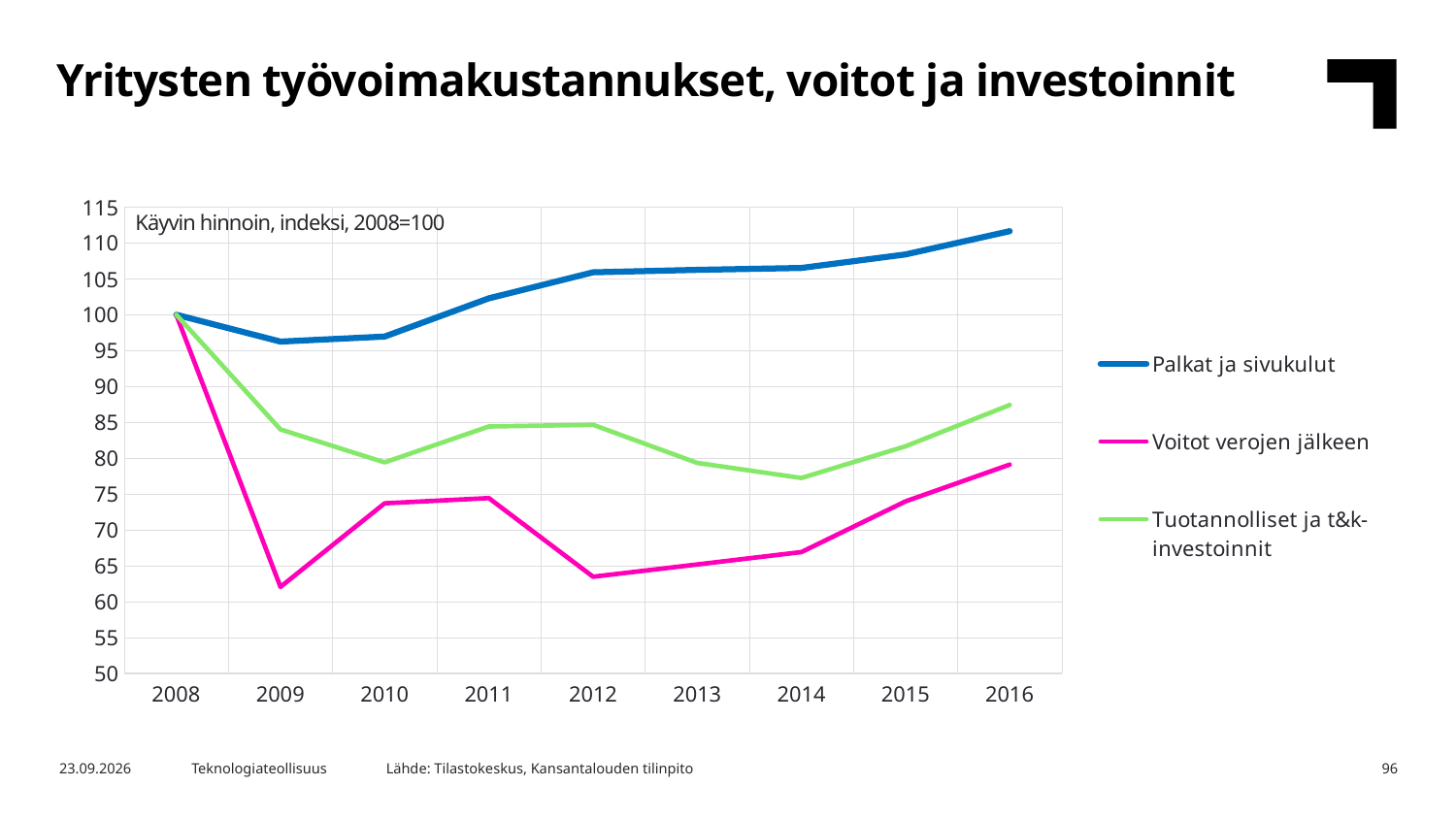
What is the index value of all three series in 2008? 100 How many years are shown on the x axis? 9 Is the value for Palkat ja sivukulut in 2016 greater or less than 110? greater Does the Palkat ja sivukulut line rise or fall from 2012 to 2016? Rise Which series has the highest value in 2016? Palkat ja sivukulut Is the value for Voitot verojen jälkeen in 2009 greater or less than 65? less What type of chart is shown on the slide? Line chart How many series does the legend list? 3 What text is shown inside the plot area at the top left of the chart? Käyvin hinnoin, indeksi, 2008=100 Is the value for Tuotannolliset ja t&k-investoinnit in 2014 greater or less than 80? less Which series has the lowest value in 2009? Voitot verojen jälkeen In 2016, which is larger: Palkat ja sivukulut or Voitot verojen jälkeen? Palkat ja sivukulut